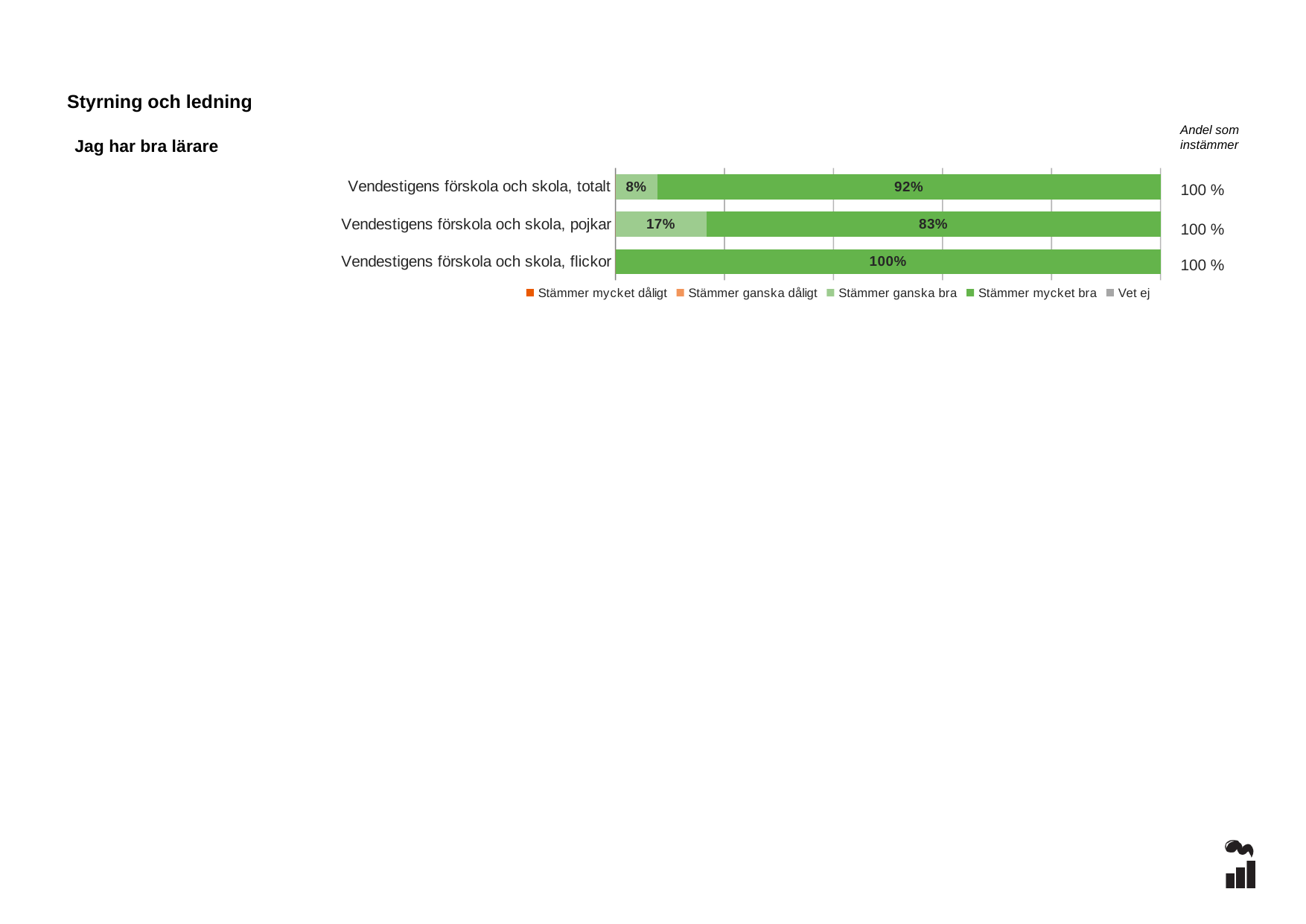
How many categories (bars) does the chart show? 3 What is the "Andel som instämmer" value shown for "Vendestigens förskola och skola, pojkar"? 100 % What is the value of "Stämmer mycket bra" for "Vendestigens förskola och skola, flickor"? 100% What is the value of "Stämmer ganska bra" for "Vendestigens förskola och skola, totalt"? 8% Which is larger: "Stämmer ganska bra" for "pojkar" or for "totalt"? pojkar How many series does the legend list? 5 What is the value of "Stämmer ganska bra" for "Vendestigens förskola och skola, pojkar"? 17% What is the difference between the "Stämmer mycket bra" values for "totalt" and "pojkar"? 9% What is the value of "Stämmer mycket bra" for "Vendestigens förskola och skola, totalt"? 92% Which category has the lowest value for "Stämmer mycket bra"? Vendestigens förskola och skola, pojkar What kind of chart is shown on the slide? Stacked bar chart Which category has the highest value for "Stämmer mycket bra"? Vendestigens förskola och skola, flickor